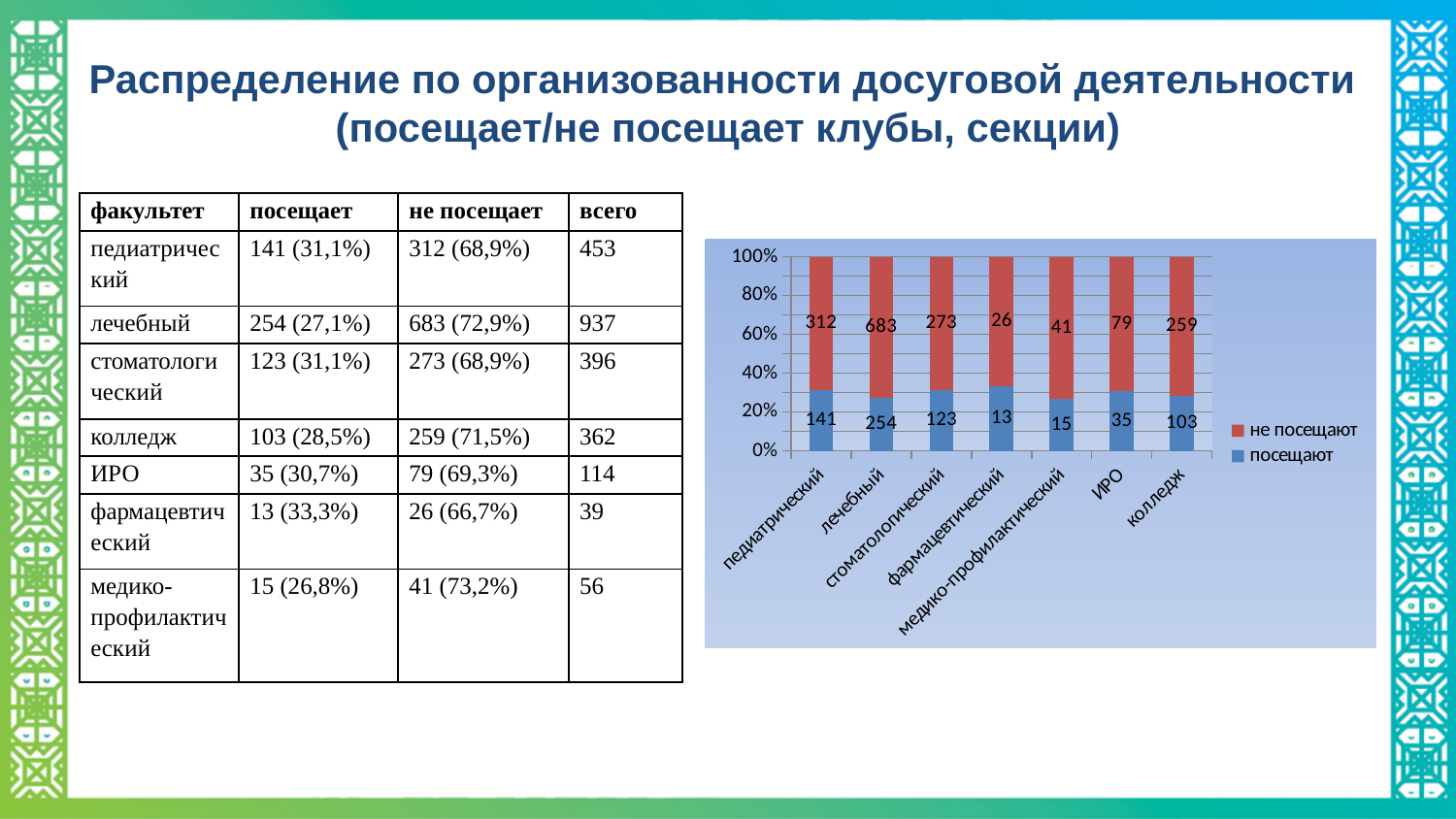
In the chart, what is the value of 'не посещают' for фармацевтический? 26 In the chart, what is the value of 'посещают' for медико-профилактический? 15 In the chart, which is larger: 'посещают' for ИРО or 'посещают' for колледж? колледж How many faculty categories are plotted on the x axis of the chart? 7 In the chart, what is the value of 'не посещают' for лечебный? 683 What kind of chart is shown on the slide? stacked bar chart In the chart, what is the value of 'посещают' for стоматологический? 123 In the chart, what is the difference between 'не посещают' and 'посещают' for педиатрический? 171 In the chart, what is the total of the stacked bar for колледж? 362 Which category has the lowest 'посещают' value in the chart? фармацевтический How many series does the chart legend list? 2 Which category has the highest 'не посещают' value in the chart? лечебный